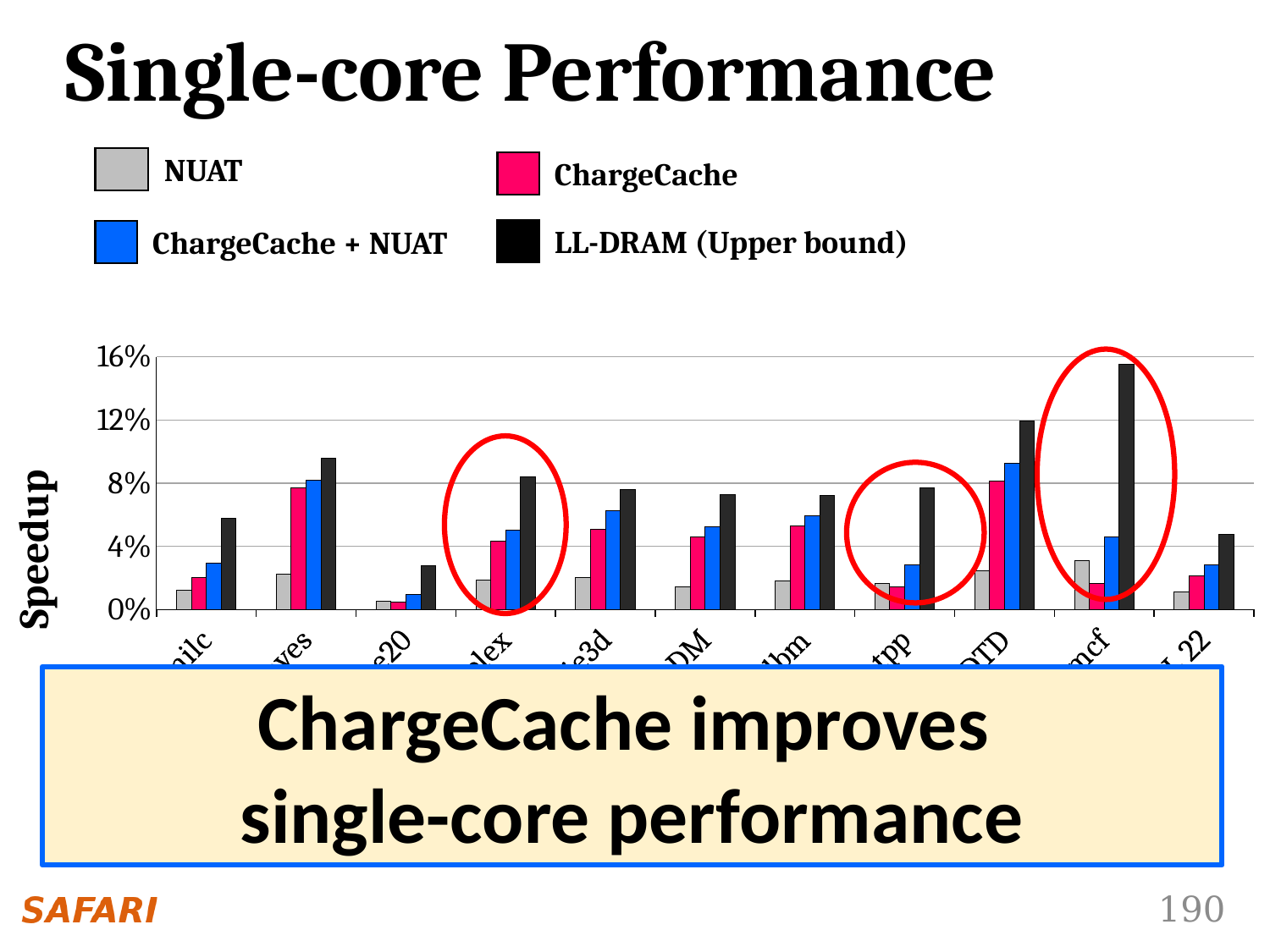
In the ninth category group from the left, which is larger: the ChargeCache + NUAT bar or the ChargeCache bar? ChargeCache + NUAT Is the LL-DRAM (Upper bound) value in the second category group from the left greater or less than 8%? greater Is the ChargeCache + NUAT value in the ninth category group from the left greater or less than 8%? greater Is the NUAT value in the third category group from the left greater or less than 4%? less Which series has the tallest bar in every category group? LL-DRAM (Upper bound) What is the label on the y axis? Speedup How many category groups are plotted along the x axis? 11 In the second category group from the left, which is larger: the ChargeCache bar or the NUAT bar? ChargeCache What kind of chart is shown on the slide? bar chart What are the four series named in the legend? NUAT, ChargeCache, ChargeCache + NUAT, LL-DRAM (Upper bound) How many series does the legend list? 4